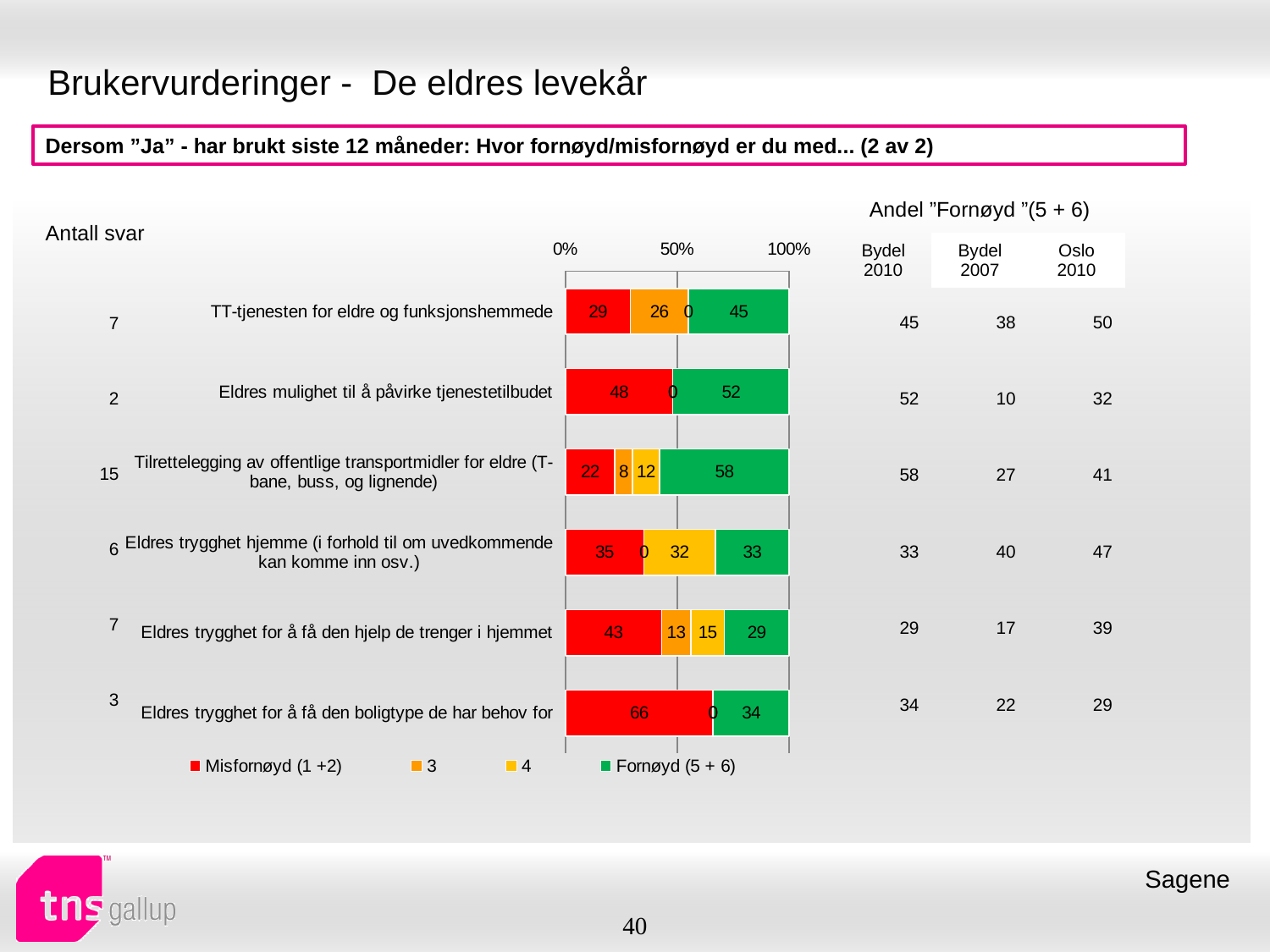
What is the difference between the Misfornøyd (1 +2) value for "Eldres trygghet for å få den boligtype de har behov for" and for "TT-tjenesten for eldre og funksjonshemmede"? 37 Which category has the lowest Fornøyd (5 + 6) value? Eldres trygghet for å få den hjelp de trenger i hjemmet What is the Fornøyd (5 + 6) value for "Tilrettelegging av offentlige transportmidler for eldre (T-bane, buss, og lignende)"? 58 What is the total of the stacked bar for "Eldres trygghet for å få den hjelp de trenger i hjemmet"? 100 Which is larger: the Fornøyd (5 + 6) value for "TT-tjenesten for eldre og funksjonshemmede" or for "Eldres mulighet til å påvirke tjenestetilbudet"? Eldres mulighet til å påvirke tjenestetilbudet How many series does the legend list? 4 Which category has the highest Fornøyd (5 + 6) value? Tilrettelegging av offentlige transportmidler for eldre (T-bane, buss, og lignende) What is the value of series "4" for "Eldres trygghet hjemme (i forhold til om uvedkommende kan komme inn osv.)"? 32 What kind of chart is shown on the slide? Stacked bar chart How many categories are shown in the chart? 6 What is the value of series "3" for "Eldres trygghet for å få den hjelp de trenger i hjemmet"? 13 What is the Misfornøyd (1 +2) value for "Eldres trygghet for å få den boligtype de har behov for"? 66